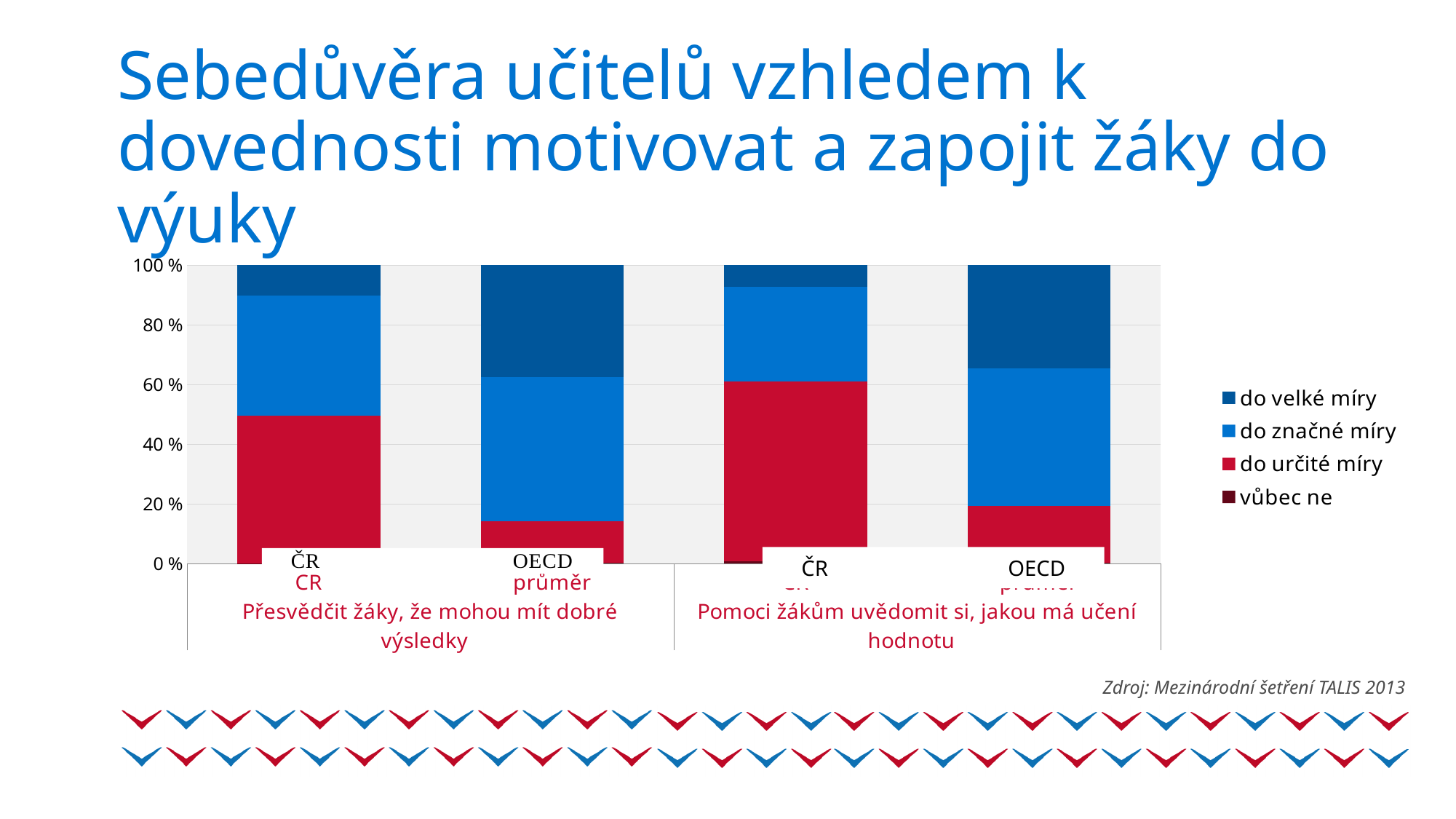
How many series does the legend list? 4 Is the 'do určité míry' share for OECD průměr in 'Přesvědčit žáky, že mohou mít dobré výsledky' greater or less than 20 %? less What kind of chart is shown on the slide? Stacked bar chart Is the 'do určité míry' share for ČR in 'Pomoci žákům uvědomit si, jakou má učení hodnotu' greater or less than 40 %? greater What source is cited below the chart? Mezinárodní šetření TALIS 2013 In 'Přesvědčit žáky, že mohou mít dobré výsledky', which has the larger 'do určité míry' share, ČR or OECD průměr? ČR For ČR, is the 'do určité míry' share larger in 'Přesvědčit žáky, že mohou mít dobré výsledky' or in 'Pomoci žákům uvědomit si, jakou má učení hodnotu'? Pomoci žákům uvědomit si, jakou má učení hodnotu What are the two groups of bars labelled along the x axis? Přesvědčit žáky, že mohou mít dobré výsledky; Pomoci žákům uvědomit si, jakou má učení hodnotu In 'Pomoci žákům uvědomit si, jakou má učení hodnotu', which has the larger 'do velké míry' share, ČR or OECD průměr? OECD průměr Is the 'do určité míry' share for OECD průměr in 'Pomoci žákům uvědomit si, jakou má učení hodnotu' greater or less than 40 %? less How many stacked bars are plotted in the chart? 4